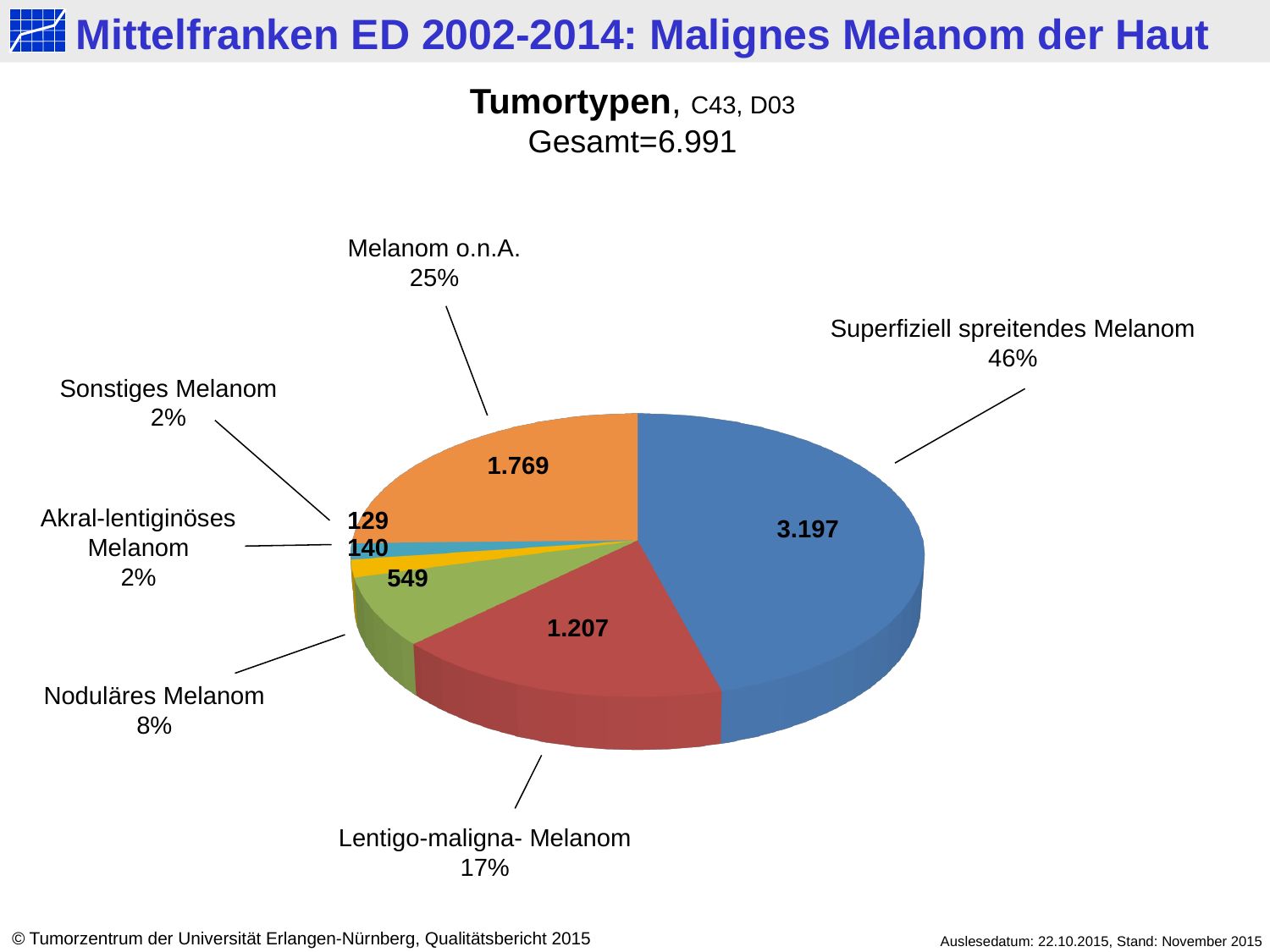
What is the number of cases shown for Noduläres Melanom? 549 What kind of chart is shown on the slide? pie chart What share of the pie does Superfiziell spreitendes Melanom account for? 46% What share of the pie does Melanom o.n.A. account for? 25% What is the number of cases shown for Superfiziell spreitendes Melanom? 3.197 What is the number of cases shown for Lentigo-maligna- Melanom? 1.207 Which has more cases, Lentigo-maligna- Melanom or Noduläres Melanom? Lentigo-maligna- Melanom How many tumour types are shown in the pie chart? 6 What share of the pie does Noduläres Melanom account for? 8% What is the difference in cases between Superfiziell spreitendes Melanom (3.197) and Melanom o.n.A. (1.769)? 1.428 What total (Gesamt) is stated in the chart subtitle? 6.991 Which tumour type has the largest slice of the pie? Superfiziell spreitendes Melanom